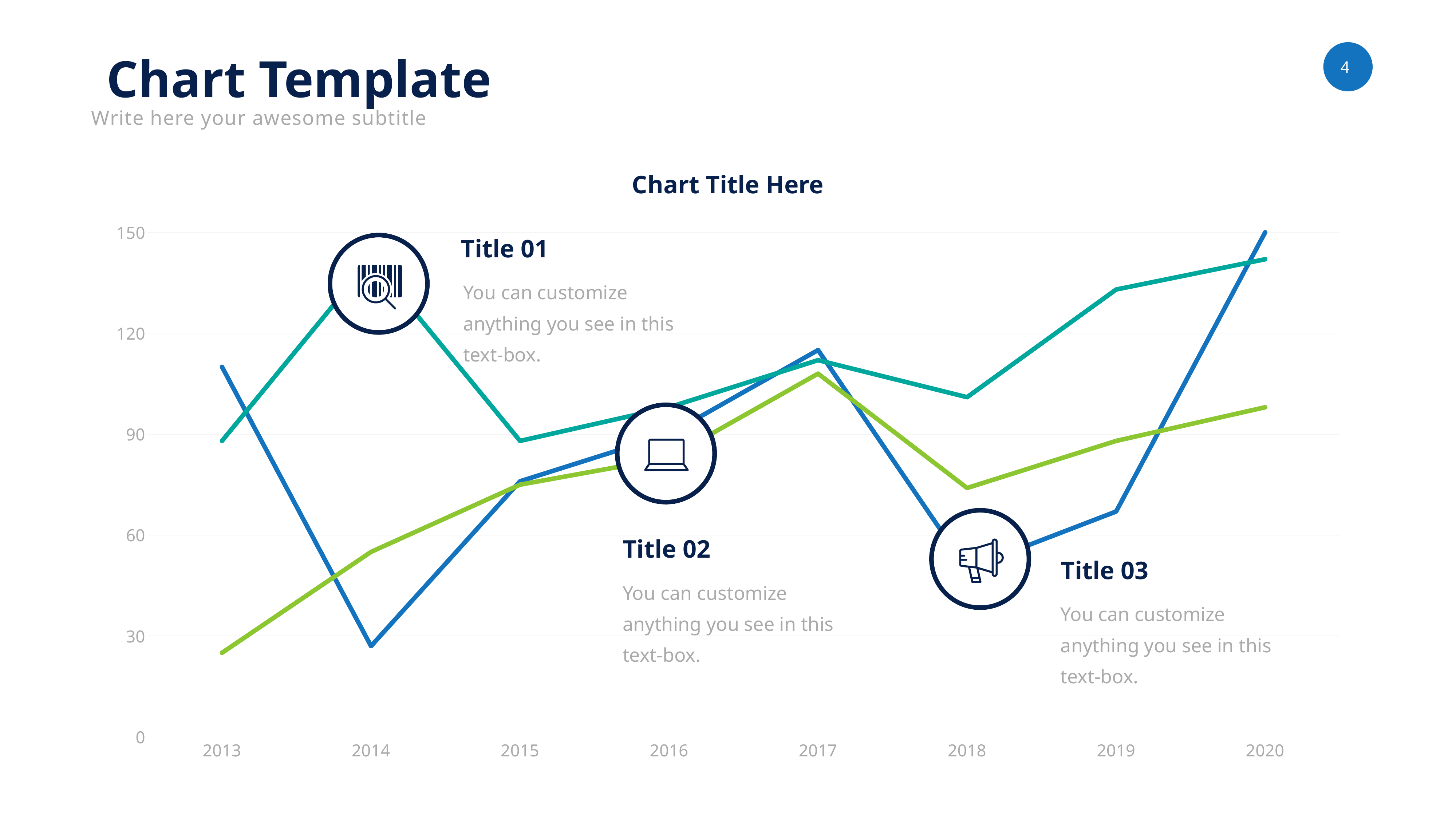
Is the value of the blue line in 2014 greater or less than 60? less What kind of chart is shown on the slide? line chart Is the value of the teal line in 2014 greater or less than 120? greater Is the value of the green line in 2013 greater or less than 60? less How many years are plotted along the x axis of the chart? 8 In which year does the blue line reach its lowest value? 2014 In 2014, which line has the higher value, the blue line or the teal line? the teal line How many lines are plotted on the chart? 3 What is the title of the chart? Chart Title Here In which year does the blue line reach its highest value? 2020